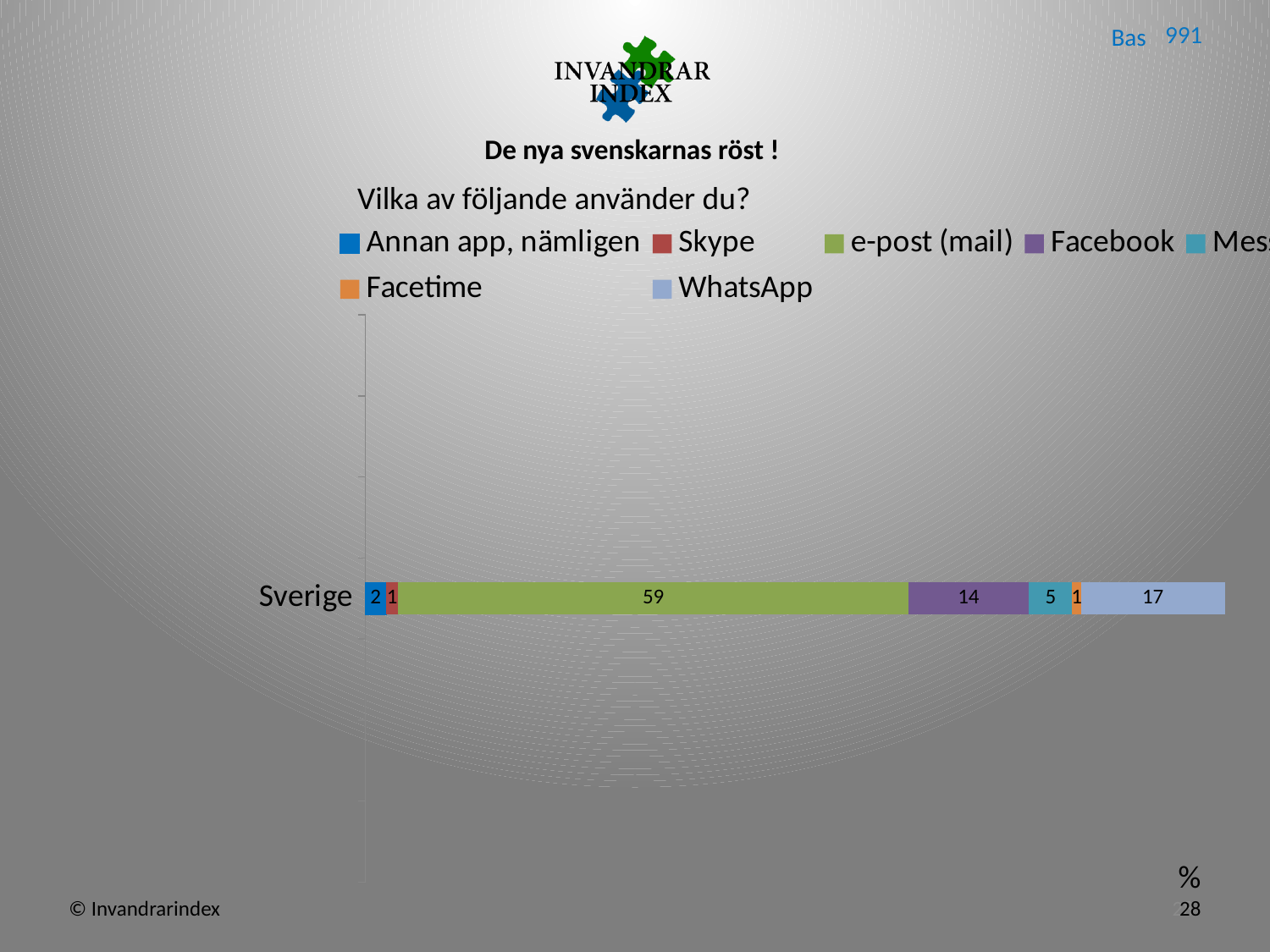
What is the value for Skype in the Sverige bar? 1 Which is larger for Sverige, the Facebook value or the WhatsApp value? WhatsApp What is the title of the chart? Vilka av följande använder du? What is the value for Facebook in the Sverige bar? 14 What is the value for WhatsApp in the Sverige bar? 17 What is the value for Annan app, nämligen in the Sverige bar? 2 What is the value for Facetime in the Sverige bar? 1 What kind of chart is shown on the slide? Bar chart How many categories are plotted on the chart? 1 What is the value for e-post (mail) in the Sverige bar? 59 What is the difference between the e-post (mail) value and the WhatsApp value for Sverige? 42 Which series has the largest segment in the Sverige bar? e-post (mail)